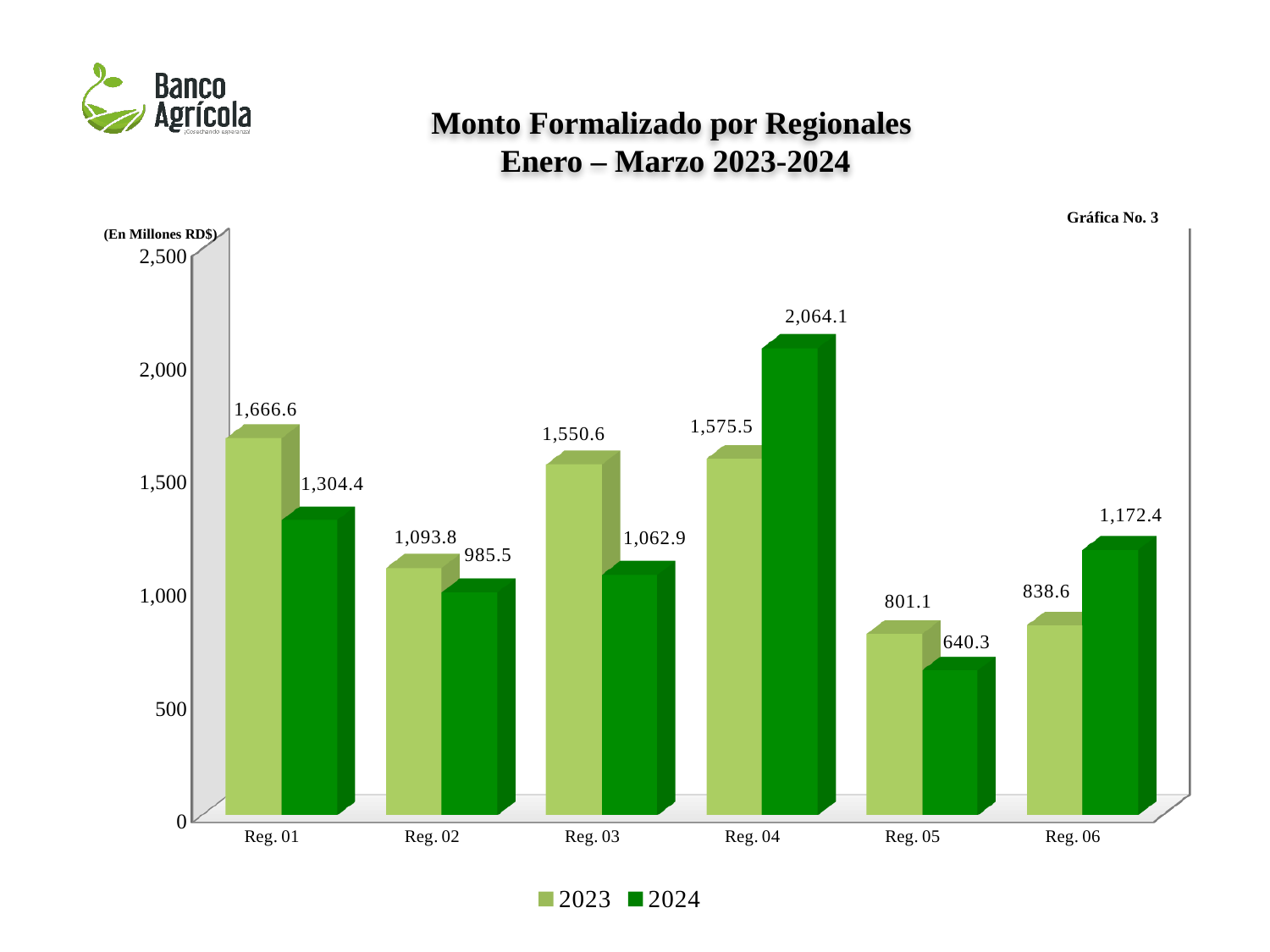
For Reg. 06, which year has the larger value, 2023 or 2024? 2024 How many series does the legend list? 2 Which region has the lowest 2023 value? Reg. 05 How many regions are shown on the x axis? 6 Is the 2023 value for Reg. 03 greater or less than 1,500? greater What is the difference between the 2023 and 2024 values for Reg. 01? 362.2 What is the 2024 value for Reg. 05? 640.3 What is the 2024 value for Reg. 04? 2,064.1 What is the difference between the 2024 and 2023 values for Reg. 04? 488.6 What is the 2023 value for Reg. 01? 1,666.6 What kind of chart is shown on the slide? Bar chart Which region has the highest 2024 value? Reg. 04